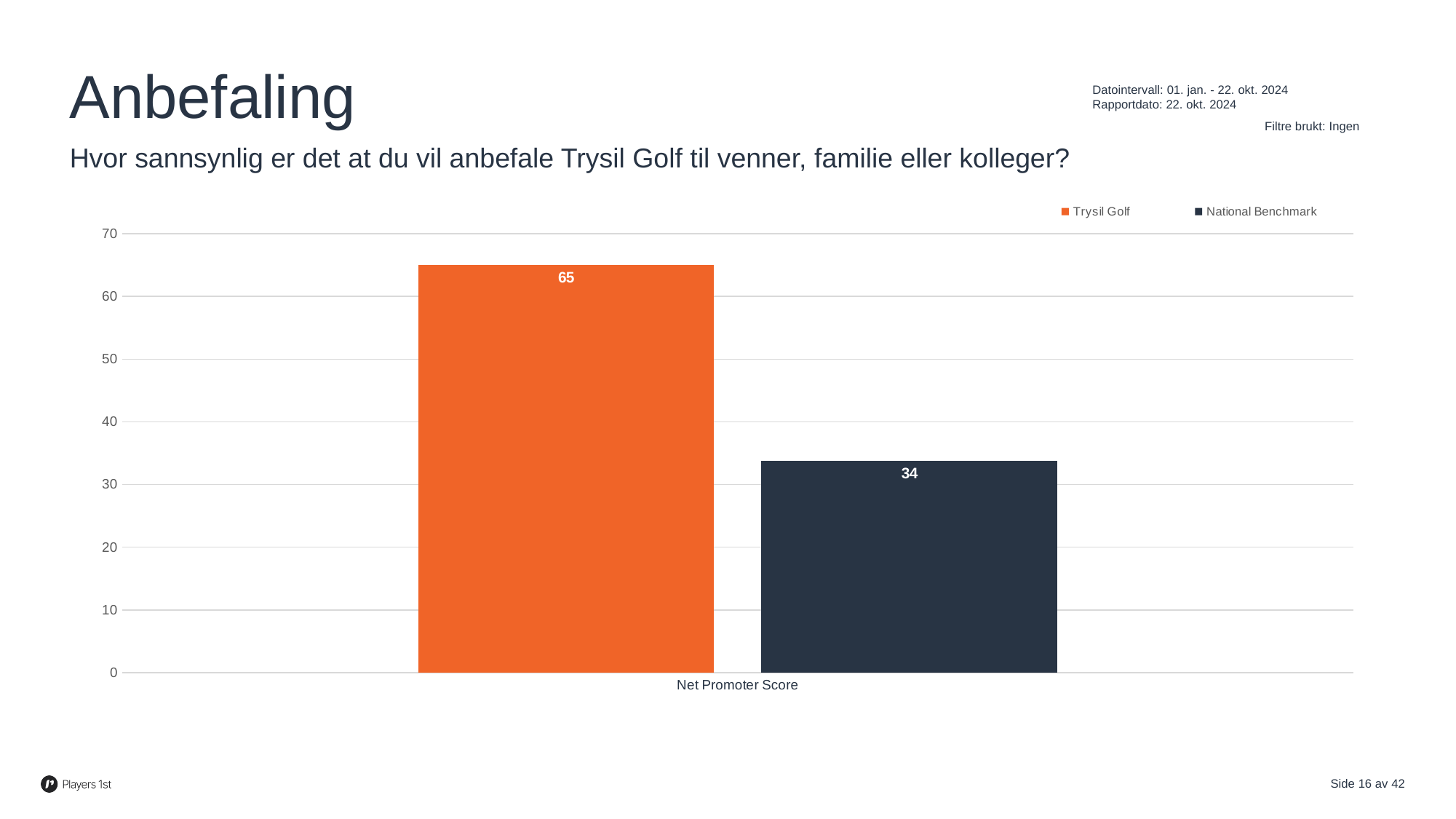
Is the value for Trysil Golf greater or less than 60? greater How many series does the legend list? 2 What is the Net Promoter Score value for Trysil Golf? 65 Is the value for National Benchmark greater or less than 40? less Which series has the higher Net Promoter Score, Trysil Golf or National Benchmark? Trysil Golf What is the highest value shown on the y axis? 70 What is the category label shown on the x axis? Net Promoter Score What is the difference between the Trysil Golf and National Benchmark Net Promoter Scores? 31 What kind of chart is shown on the slide? Bar chart What is the Net Promoter Score value for National Benchmark? 34 Which series has the lowest value on the chart? National Benchmark What colour is the bar for Trysil Golf? Orange